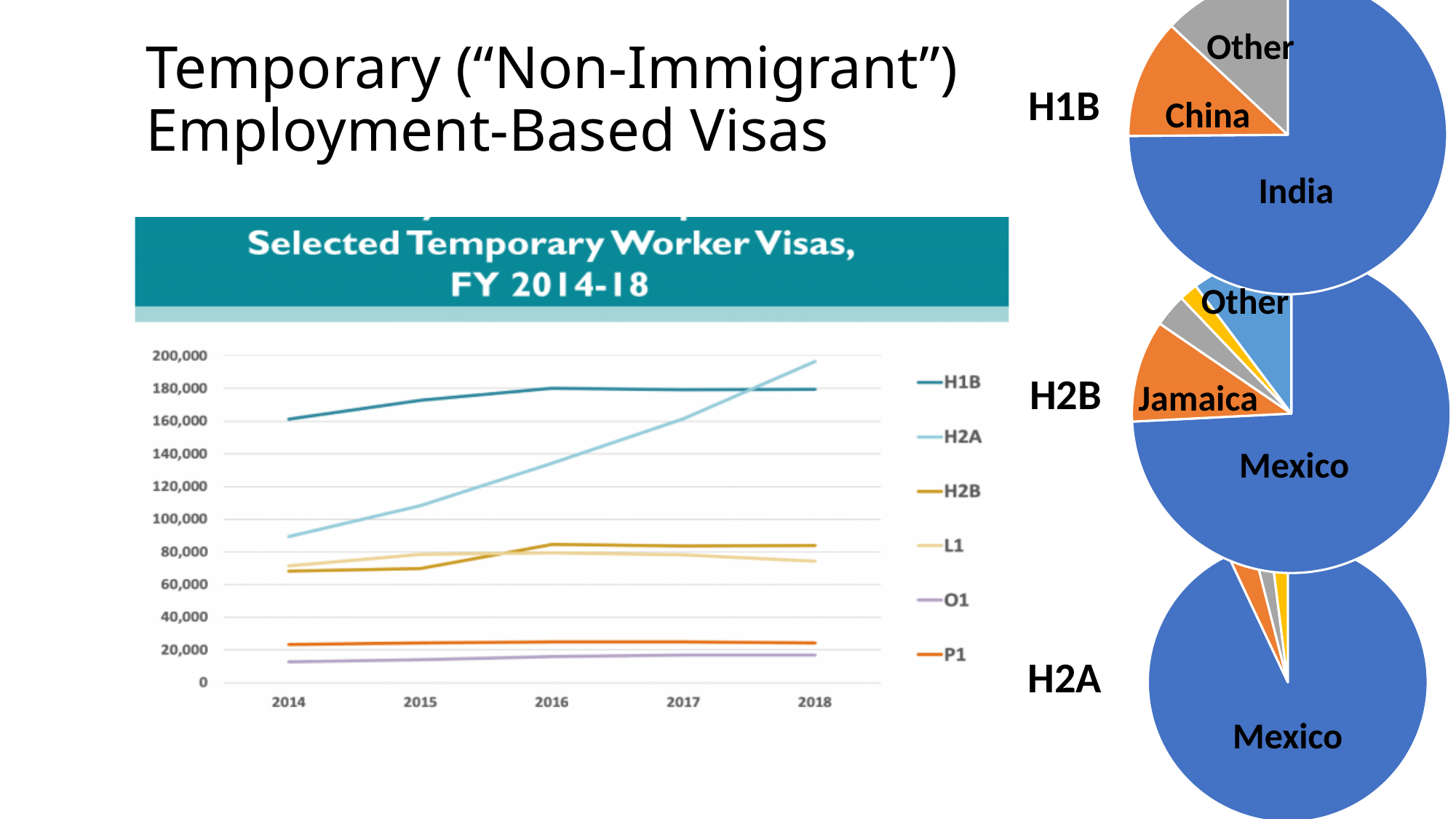
In the 'Selected Temporary Worker Visas, FY 2014-18' chart, is the H2A value in 2014 greater or less than 100,000? less In the 'Selected Temporary Worker Visas, FY 2014-18' chart, which series has the highest value in 2018? H2A In the 'Selected Temporary Worker Visas, FY 2014-18' chart, is the P1 value in 2018 greater or less than 40,000? less How many series does the legend of the 'Selected Temporary Worker Visas, FY 2014-18' chart list? 6 What kind of chart is the 'Selected Temporary Worker Visas, FY 2014-18' chart? line chart In the H1B pie chart on the right of the slide, which country has the largest slice? India In the H2B pie chart on the right of the slide, which country has the largest slice? Mexico In the 'Selected Temporary Worker Visas, FY 2014-18' chart, is the H1B value in 2016 greater or less than 160,000? greater How many years are shown on the x axis of the 'Selected Temporary Worker Visas, FY 2014-18' chart? 5 In the 'Selected Temporary Worker Visas, FY 2014-18' chart, which series has the lowest value in 2014? O1 In the 'Selected Temporary Worker Visas, FY 2014-18' chart, which is larger in 2014: H1B or H2A? H1B In the 'Selected Temporary Worker Visas, FY 2014-18' chart, does the H2A line rise or fall from 2014 to 2018? rise